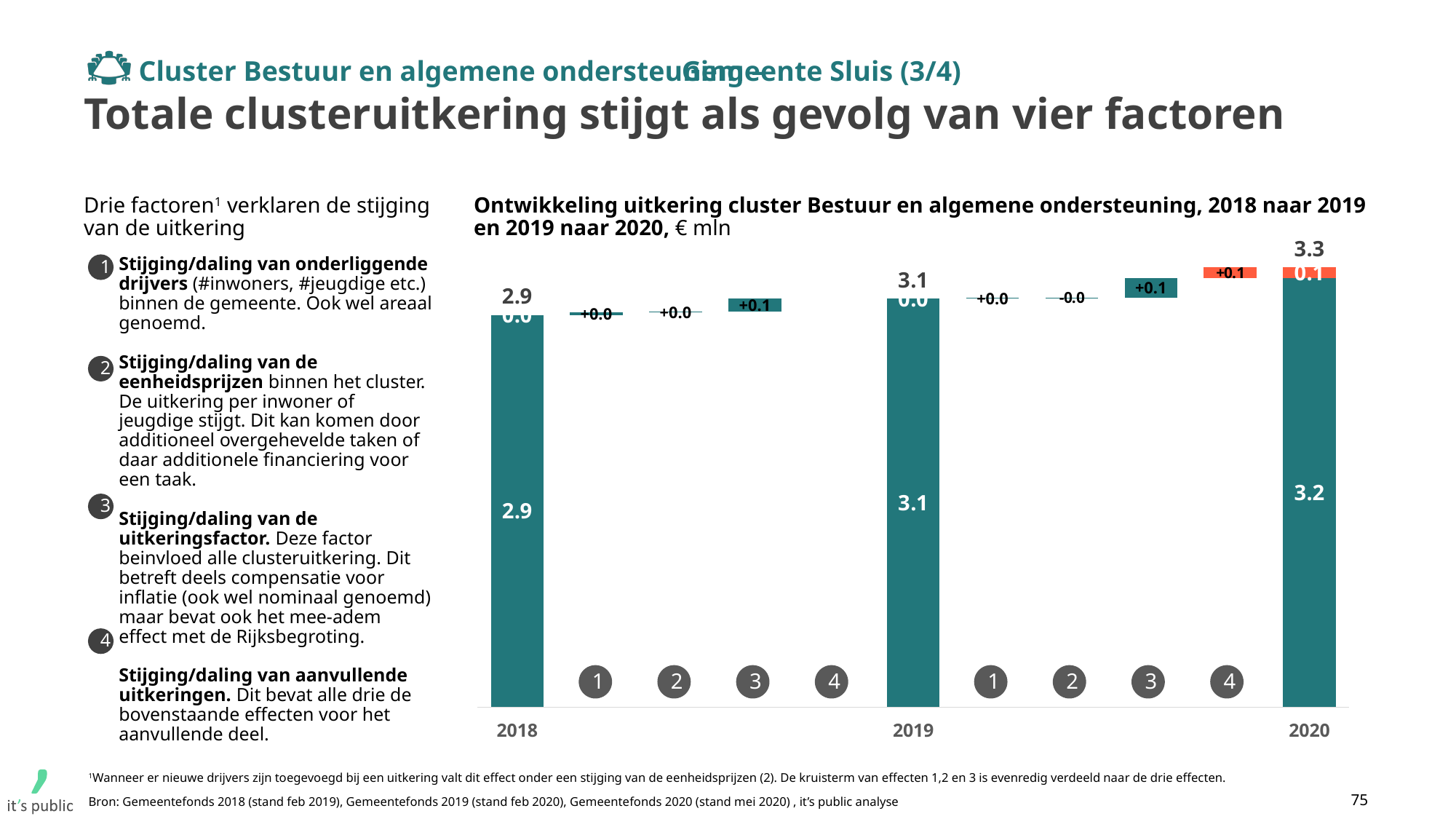
Do the total values rise or fall from 2018 to 2020? rise What is the total uitkering shown for 2018? 2.9 What is the total uitkering shown for 2019? 3.1 Is the total for 2019 larger or smaller than the total for 2018? larger Which year has the lowest total uitkering? 2018 What is the effect of factor 4 (aanvullende uitkeringen) from 2019 to 2020? +0.1 Which year has the highest total uitkering? 2020 In what unit are the values in the chart expressed? € mln What is the effect of factor 3 (uitkeringsfactor) from 2018 to 2019? +0.1 What is the difference between the total for 2020 and the total for 2018? 0.4 What is the total uitkering shown for 2020? 3.3 What is the value of the orange (aanvullende) segment in the 2020 bar? 0.1